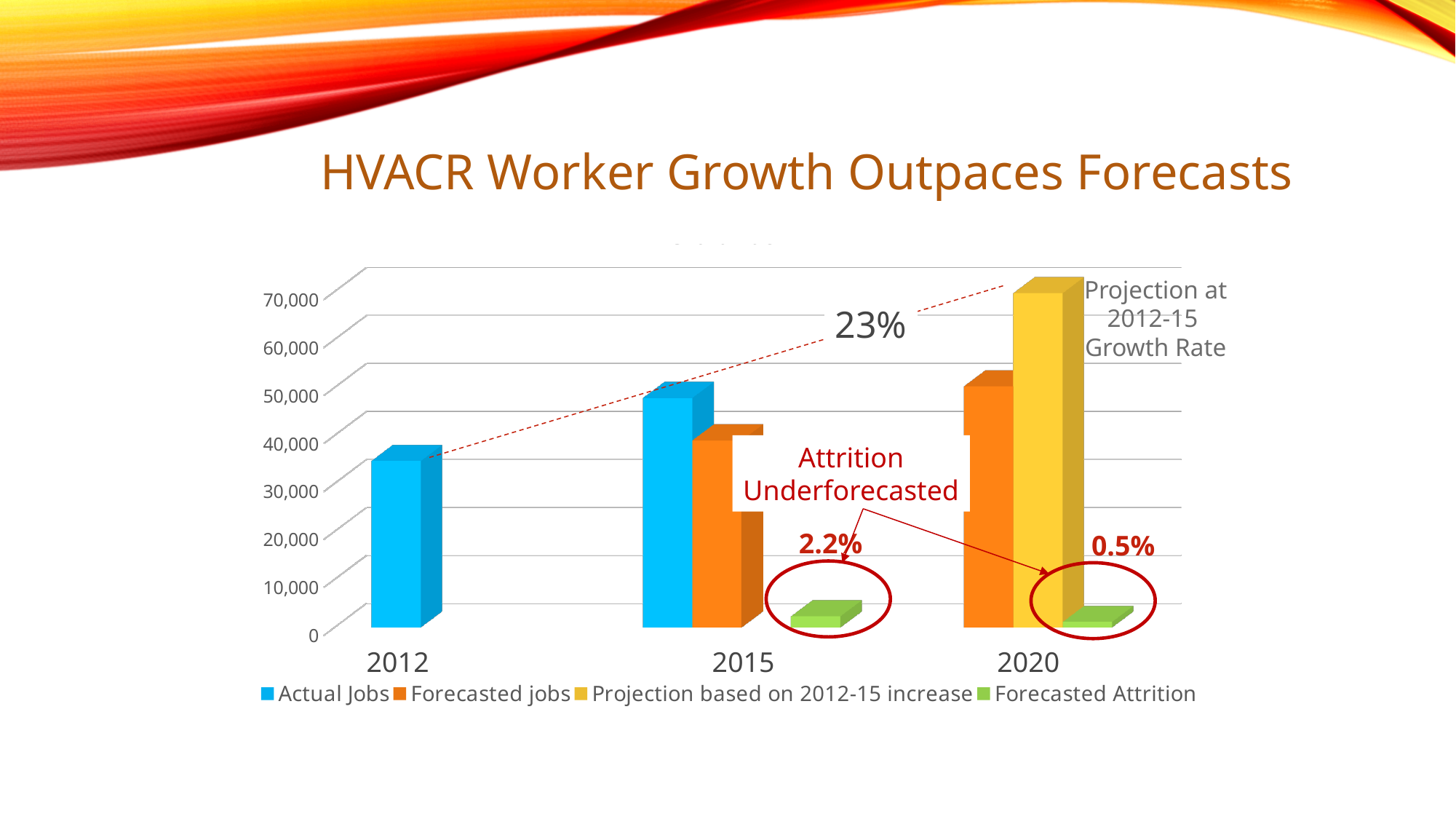
Is the value for Actual Jobs in 2012 greater or less than 30,000? greater Is the value for Projection based on 2012-15 increase in 2020 greater or less than 60,000? greater How many year categories are shown on the x axis? 3 Is the value for Forecasted jobs in 2020 greater or less than 40,000? greater Which bar is the shortest in the chart? Forecasted Attrition for 2020 In 2015, which is larger: Actual Jobs or Forecasted jobs? Actual Jobs What kind of chart is shown on the slide? bar chart How many series does the chart legend list? 4 Which bar is the tallest in the chart? Projection based on 2012-15 increase for 2020 Do the Forecasted jobs values rise or fall from 2015 to 2020? rise